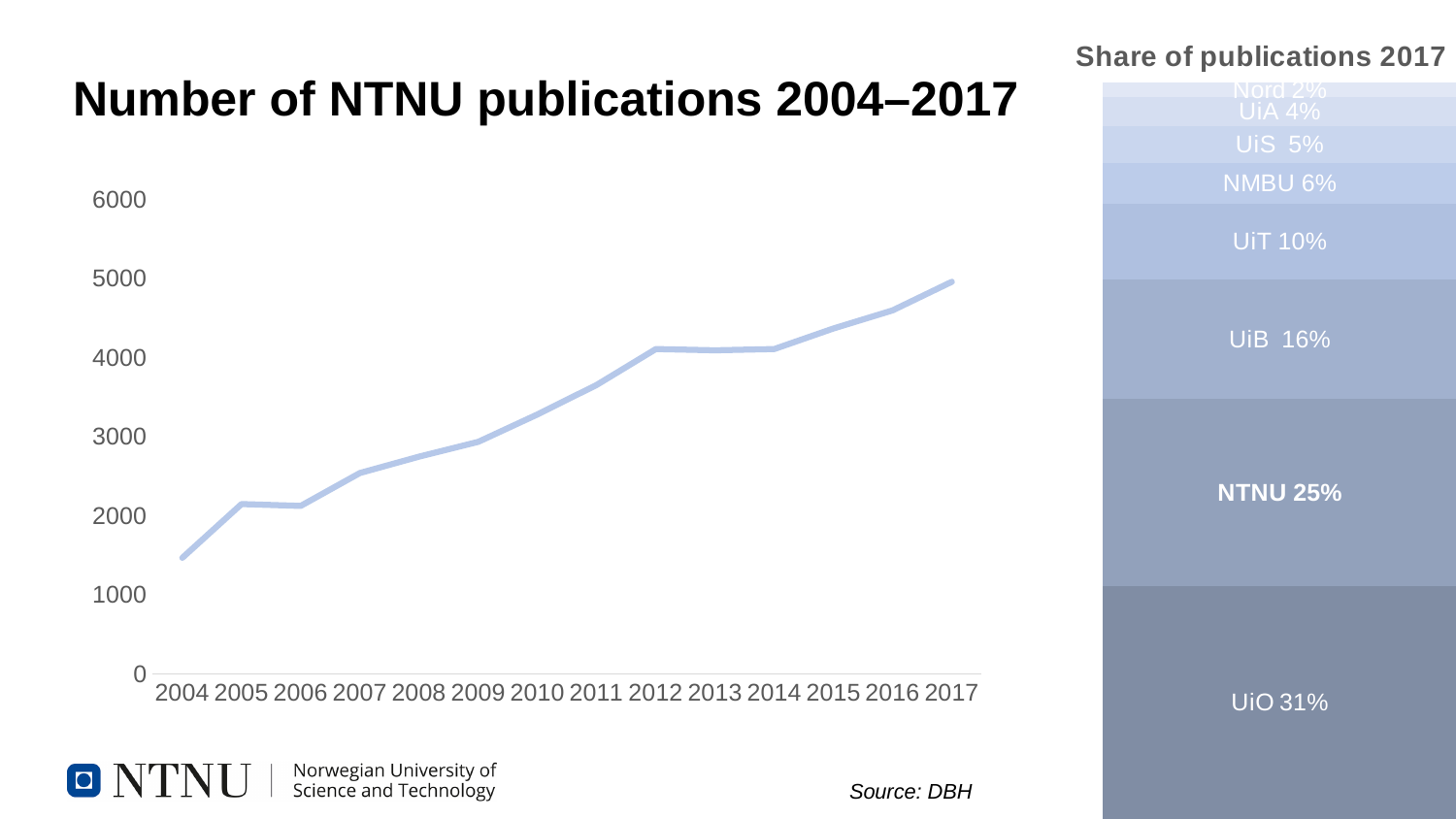
In the 'Number of NTNU publications 2004–2017' chart, is the value for 2016 greater or less than 4000? greater In the 'Number of NTNU publications 2004–2017' chart, is the value for 2011 greater or less than 4000? less What kind of chart is the 'Number of NTNU publications 2004–2017' chart? line chart In the 'Number of NTNU publications 2004–2017' chart, which year has the highest number of publications? 2017 In the 'Number of NTNU publications 2004–2017' chart, how many years are shown on the x axis? 14 In the 'Share of publications 2017' chart, what is the share for NTNU? 25% In the 'Number of NTNU publications 2004–2017' chart, do the values generally rise or fall from 2004 to 2017? rise In the 'Share of publications 2017' chart, how many institutions are shown? 8 In the 'Share of publications 2017' chart, which institution has the largest share? UiO In the 'Number of NTNU publications 2004–2017' chart, which year has the lowest number of publications? 2004 In the 'Number of NTNU publications 2004–2017' chart, is the value for 2004 greater or less than 2000? less In the 'Share of publications 2017' chart, what is the difference between the shares of UiO and NTNU? 6%